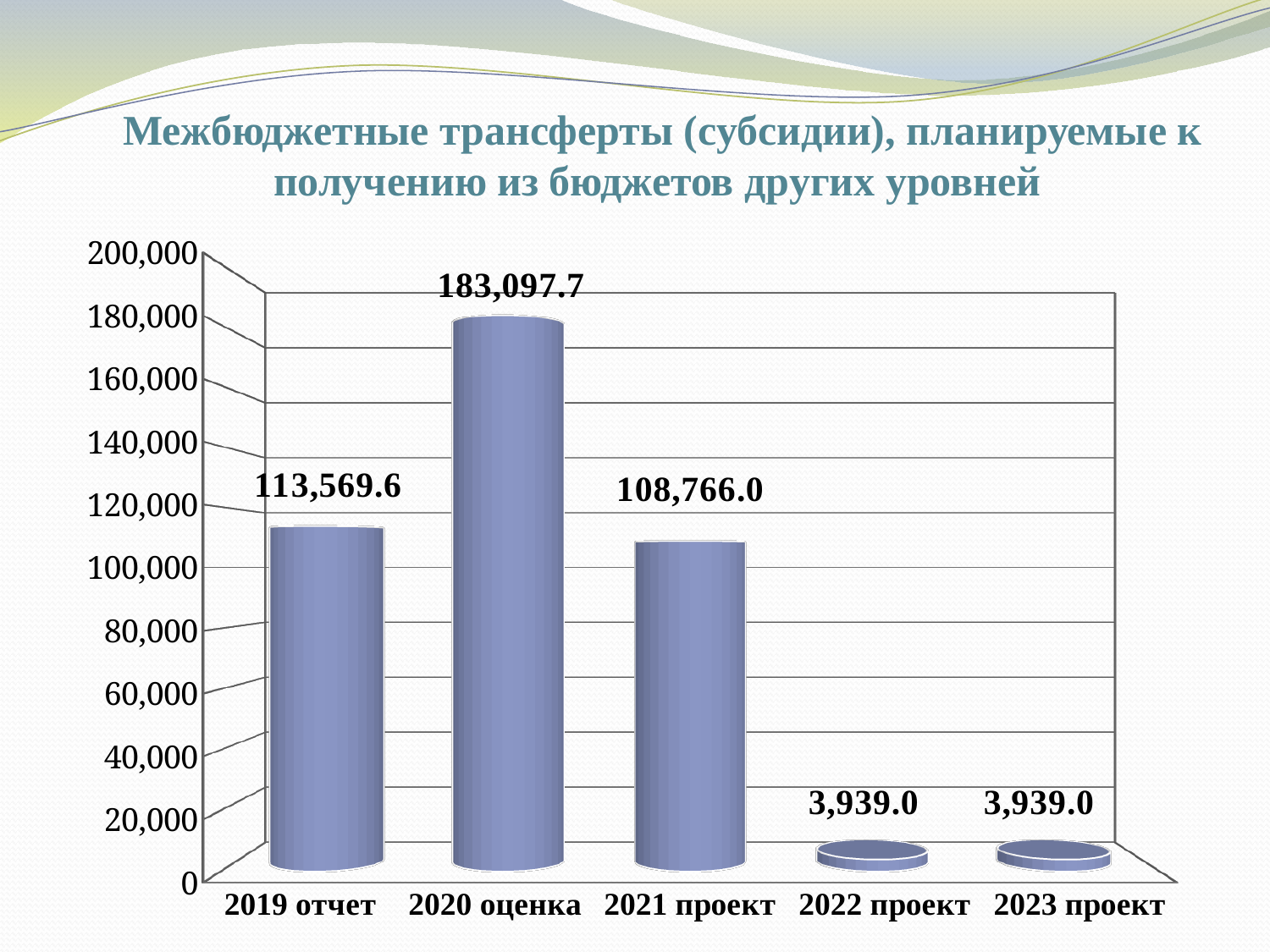
What is the value for 2020 оценка? 183,097.7 What kind of chart is shown on the slide? bar chart What is the difference between the values for 2019 отчет and 2021 проект? 4,803.6 What is the value for 2021 проект? 108,766.0 What is the value for 2023 проект? 3,939.0 What is the value for 2019 отчет? 113,569.6 What is the lowest value shown on the chart? 3,939.0 Which category has the highest value? 2020 оценка How many categories are shown on the x axis? 5 Is the value for 2021 проект greater or less than 120,000? less Which is larger, the value for 2019 отчет or the value for 2021 проект? 2019 отчет What is the difference between the values for 2020 оценка and 2019 отчет? 69,528.1